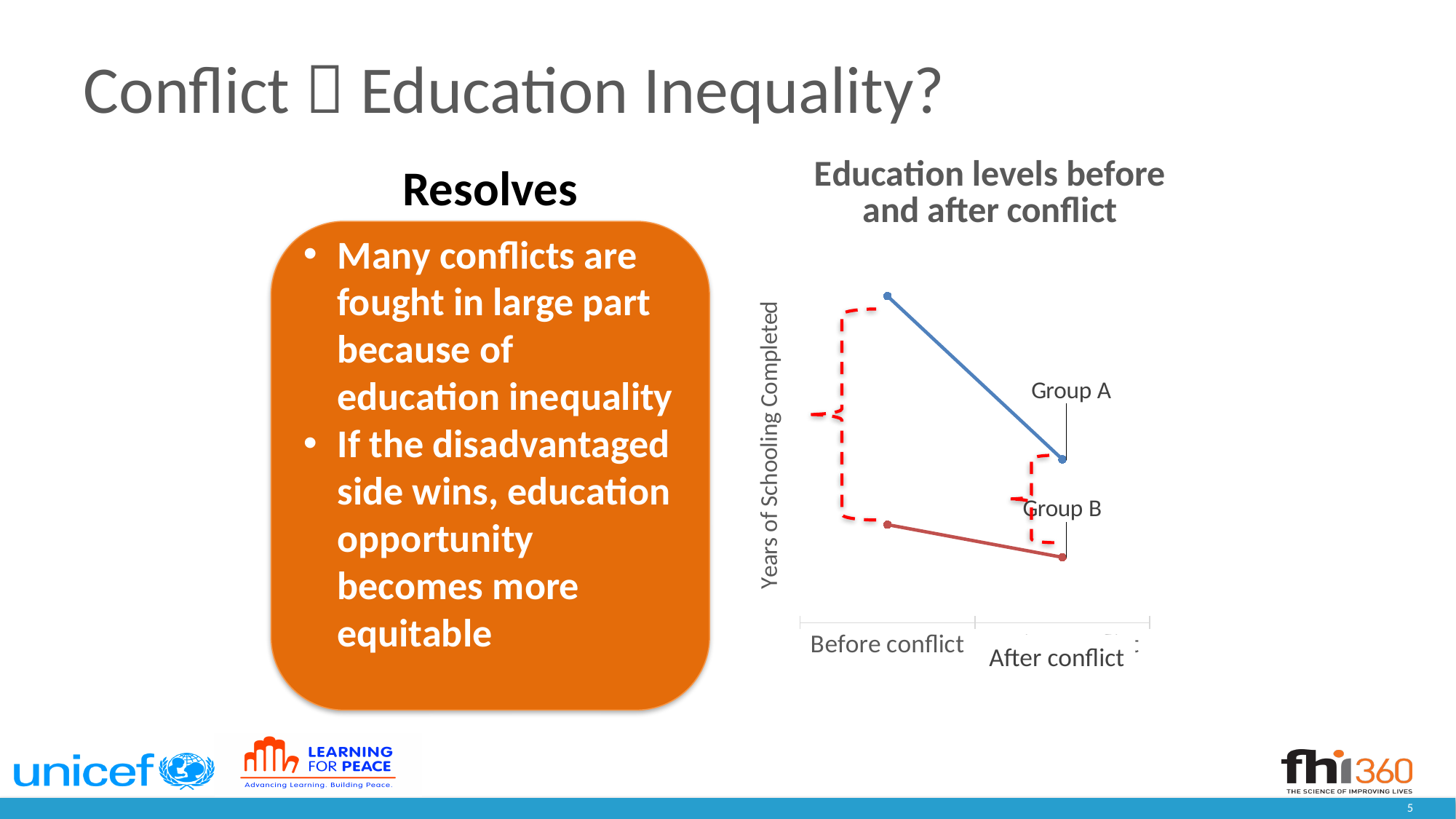
What is the title of the chart? Education levels before and after conflict How many groups (series) are plotted in the chart? 2 How many categories are shown on the x axis of the chart? 2 Which group has more years of schooling completed after conflict, Group A or Group B? Group A Which group has more years of schooling completed before conflict, Group A or Group B? Group A Which group shows the larger drop in years of schooling completed between before and after conflict? Group A What are the two categories on the x axis of the chart? Before conflict, After conflict What kind of chart is shown under the title "Education levels before and after conflict"? line chart Does the line for Group B rise or fall from "Before conflict" to "After conflict"? fall Does the line for Group A rise or fall from "Before conflict" to "After conflict"? fall What is the label on the y axis of the chart? Years of Schooling Completed